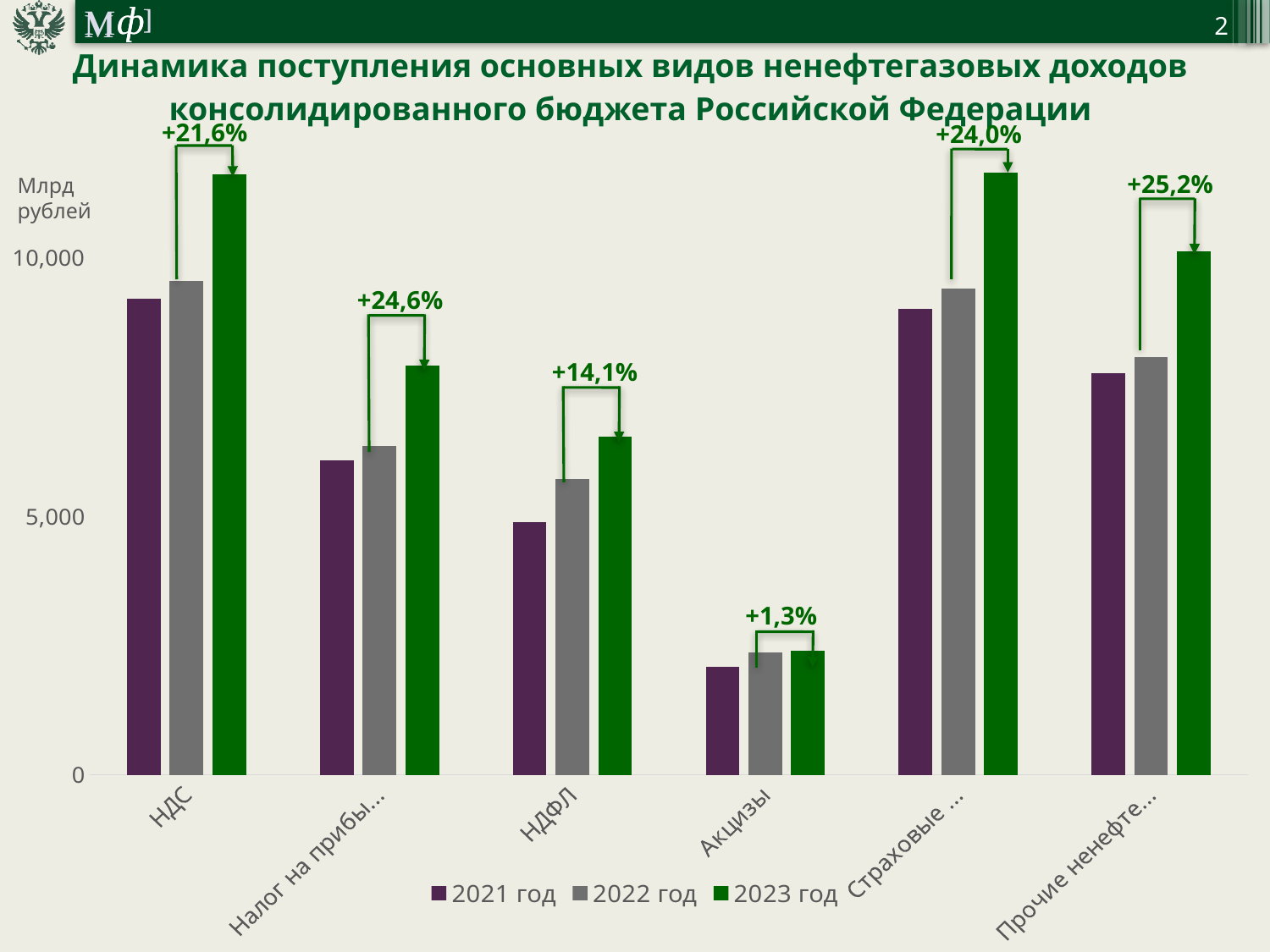
How many series does the legend list? 3 How many categories are shown along the x axis? 6 What growth percentage is printed above the НДС bars? +21,6% Is the value for Акцизы in 2023 год greater or less than 5,000? less Which category has the lowest printed growth percentage? Акцизы What is the highest growth percentage printed on the chart? +25,2% Which is larger, the 2023 год value for НДС or the 2023 год value for НДФЛ? НДС What growth percentage is printed above the НДФЛ bars? +14,1% What kind of chart is shown on the slide? bar chart What growth percentage is printed above the Акцизы bars? +1,3% What unit is shown on the vertical axis? Млрд рублей Is the value for НДС in 2023 год greater or less than 10,000? greater